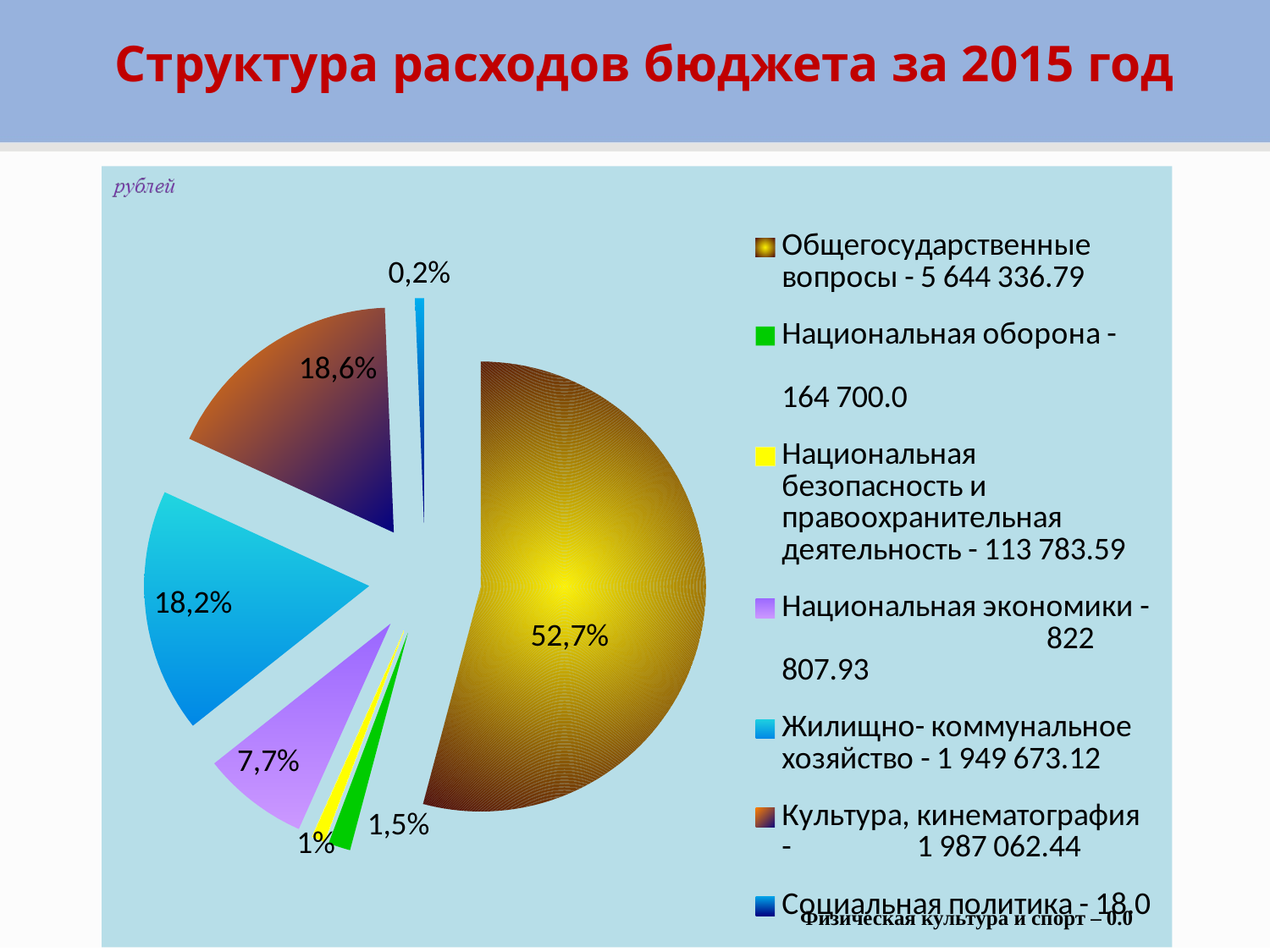
What percentage is shown for the Жилищно-коммунальное хозяйство slice? 18,2% What percentage is shown for the Национальная экономики slice? 7,7% What is the difference in percentage points between the Национальная оборона slice and the Национальная безопасность и правоохранительная деятельность slice? 0,5% What amount in rubles does the legend give for Жилищно-коммунальное хозяйство? 1 949 673.12 Which slice is larger: Культура, кинематография or Жилищно-коммунальное хозяйство? Культура, кинематография What percentage is shown for the Культура, кинематография slice? 18,6% What is the title of the slide? Структура расходов бюджета за 2015 год What kind of chart is shown on the slide? pie chart Which category has the smallest slice of the pie? Социальная политика Which category has the largest slice of the pie? Общегосударственные вопросы What share of the pie does the slice for Общегосударственные вопросы have? 52,7% How many slices does the pie chart have? 7